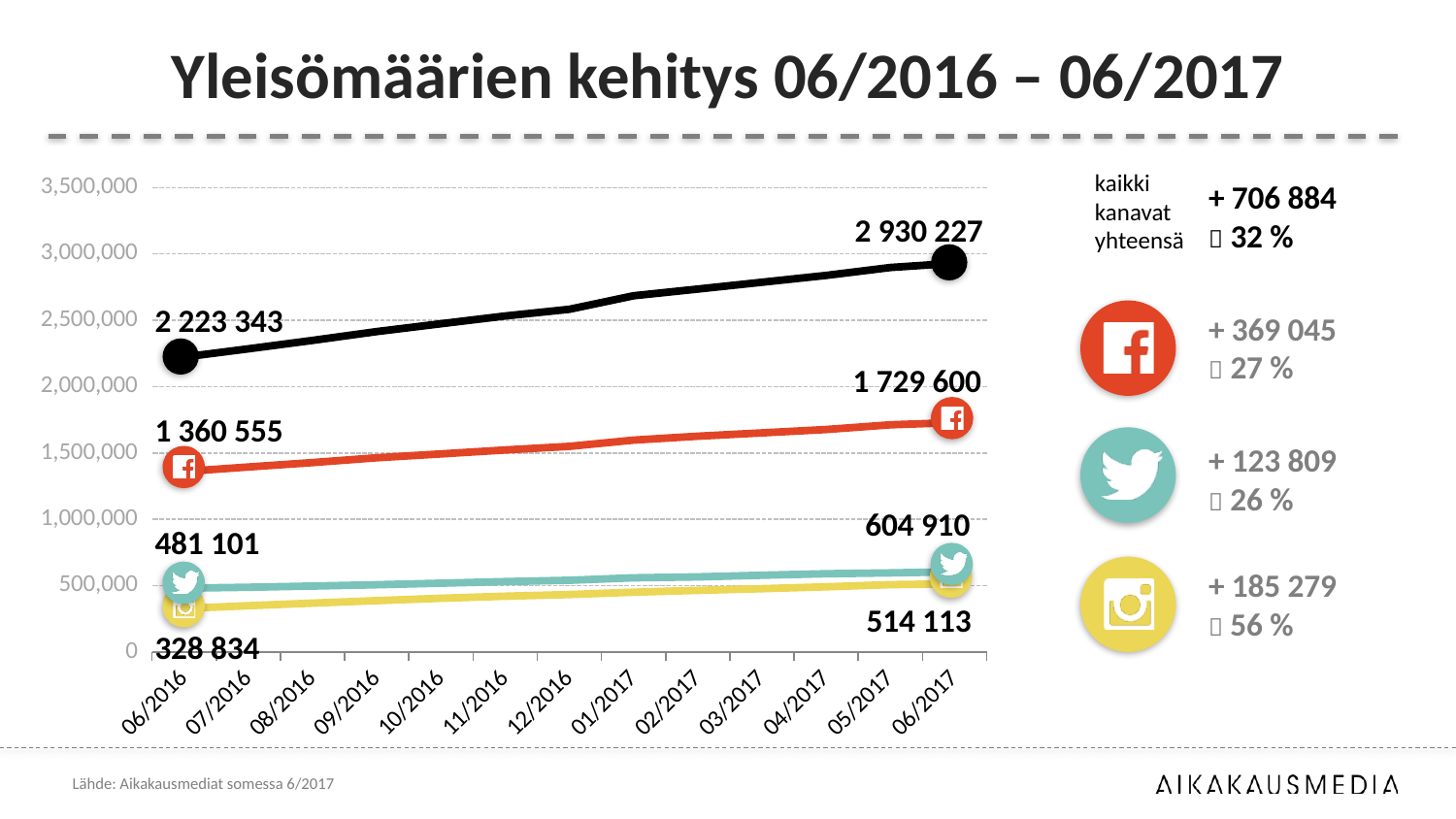
Which line has the lowest value at 06/2017? Instagram Which is larger at 06/2017, the Twitter line or the Instagram line? Twitter How many months are shown on the x axis? 13 Do the lines rise or fall from 06/2016 to 06/2017? rise What is the value of the Facebook line at 06/2016? 1 360 555 By how much did the Facebook line increase from 06/2016 to 06/2017? 369 045 What is the value of the Instagram line at 06/2016? 328 834 What is the value of the black line (kaikki kanavat yhteensä) at 06/2016? 2 223 343 By how much did the Instagram line increase from 06/2016 to 06/2017? 185 279 What is the value of the Twitter line at 06/2017? 604 910 What kind of chart is shown on the slide? line chart What is the value of the black line (kaikki kanavat yhteensä) at 06/2017? 2 930 227